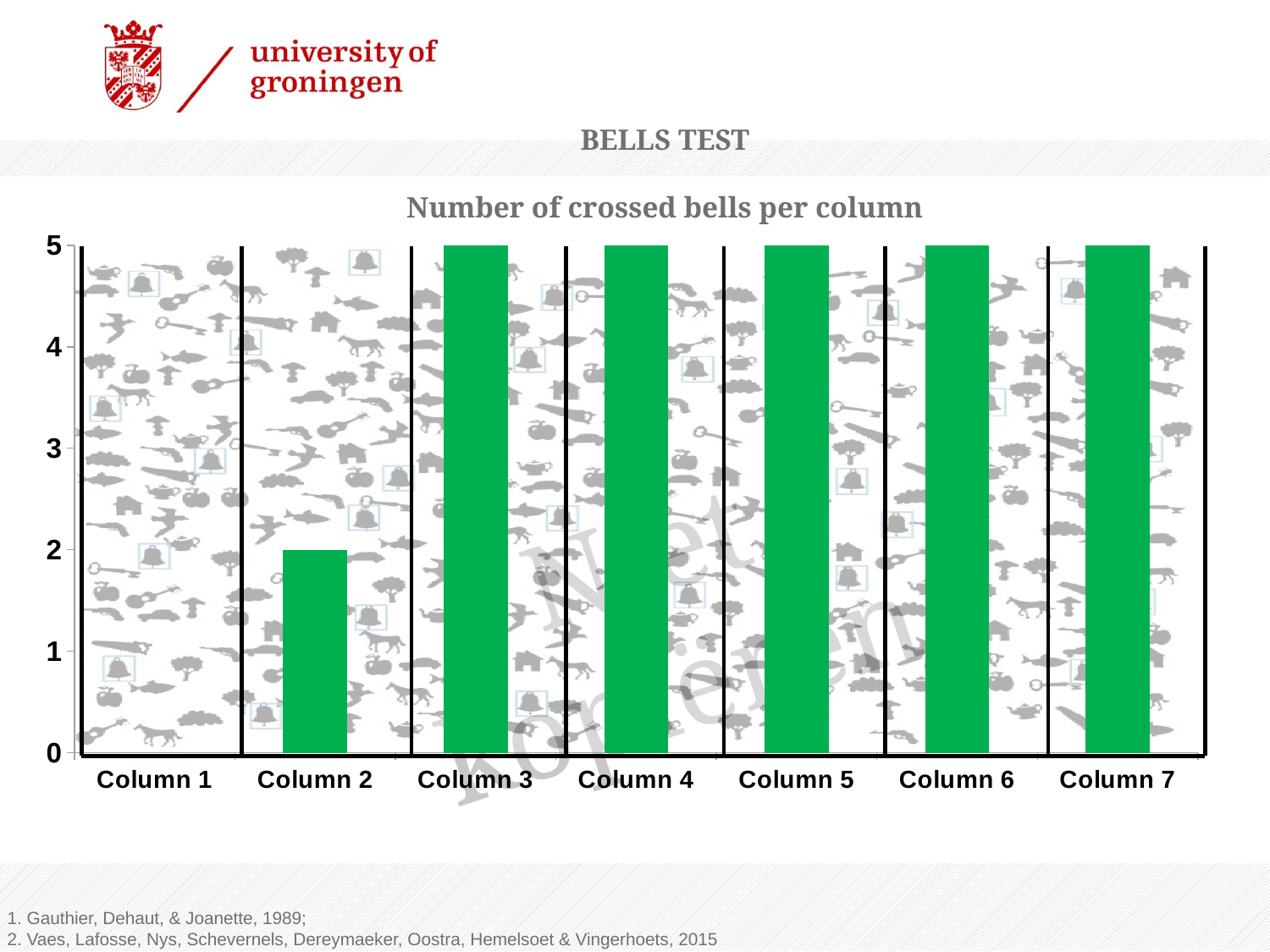
Which has more crossed bells, Column 2 or Column 4? Column 4 What is the number of crossed bells for Column 3? 5 Do the values rise or fall from Column 1 to Column 3? rise What kind of chart is shown on the slide? bar chart Which column has the lowest number of crossed bells? Column 1 What is the number of crossed bells for Column 2? 2 What colour are the bars in the chart? green Is the value for Column 2 greater or less than 3? less What is the number of crossed bells for Column 1? 0 What is the title of the chart? Number of crossed bells per column How many columns (categories) are shown on the x axis of the chart? 7 What is the difference in crossed bells between Column 3 and Column 2? 3